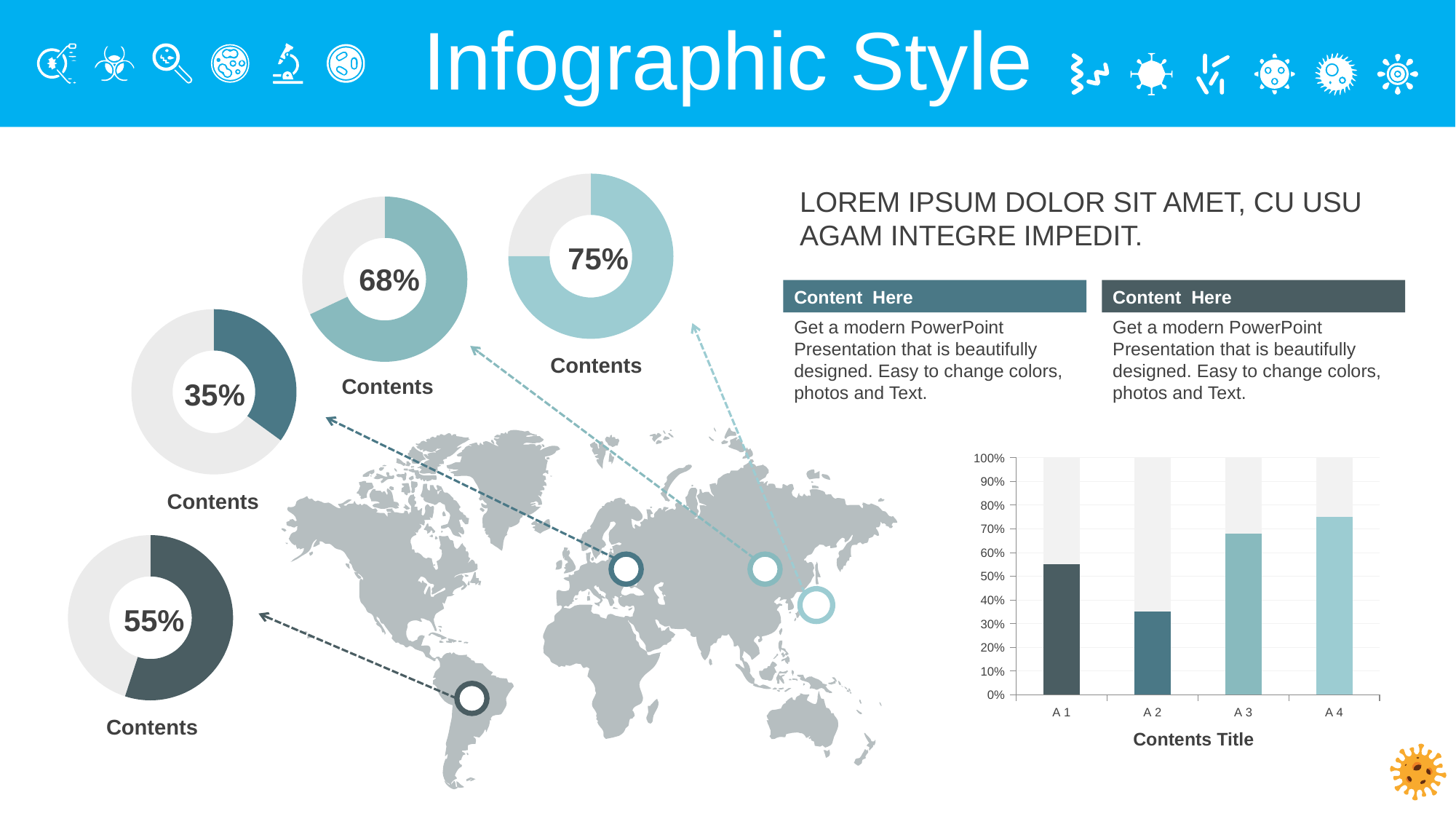
In the "Contents Title" bar chart, is the coloured bar for A 3 taller or shorter than the coloured bar for A 1? taller What is the difference between the percentages shown in the 68% donut chart and the 35% donut chart? 33% In the "Contents Title" bar chart, is the coloured value for A 1 greater or less than 50%? greater What kind of chart is the chart titled "Contents Title" at the bottom right of the slide? bar chart In the "Contents Title" bar chart, is the coloured value for A 2 greater or less than 40%? less In the "Contents Title" bar chart, which category has the tallest coloured bar? A 4 Which of the four donut charts on the slide shows the lowest percentage? 35% What percentage is shown in the centre of the top-right donut chart (the one nearest the text block)? 75% In the "Contents Title" bar chart, which category has the shortest coloured bar? A 2 How many categories does the "Contents Title" bar chart show on its x axis? 4 In the "Contents Title" bar chart, is the coloured value for A 4 greater or less than 70%? greater What percentage is shown in the centre of the donut chart at the bottom left of the slide? 55%